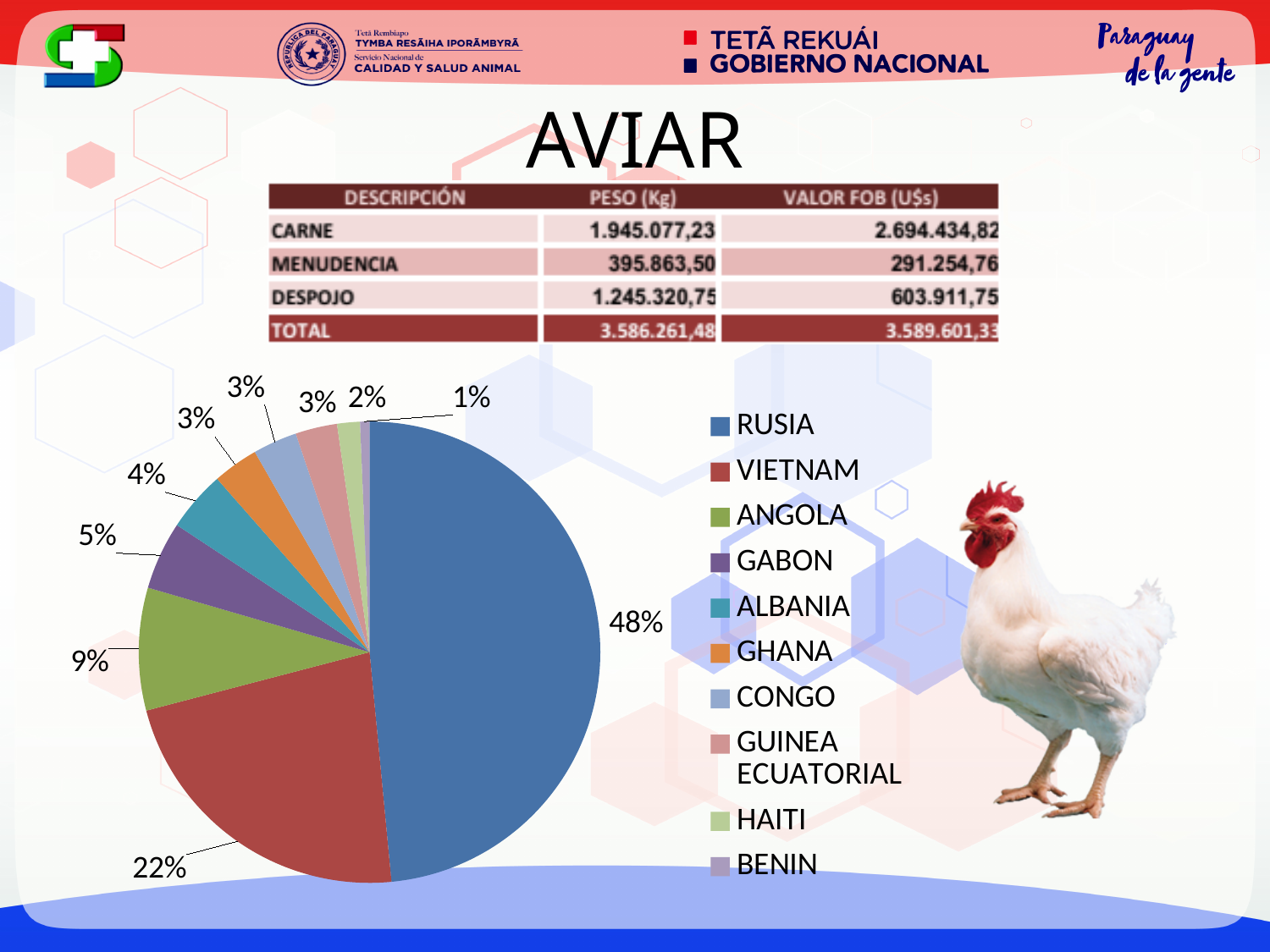
What share of the pie does ANGOLA hold? 9% Which country has the largest slice of the pie? RUSIA Which country has the smallest slice of the pie? BENIN What share of the pie does RUSIA hold? 48% What is the difference in percentage points between the RUSIA and VIETNAM slices? 26 What share of the pie does HAITI hold? 2% What kind of chart is shown on the slide? pie chart How many countries are listed in the legend of the pie chart? 10 Which slice is larger, ANGOLA or GABON? ANGOLA